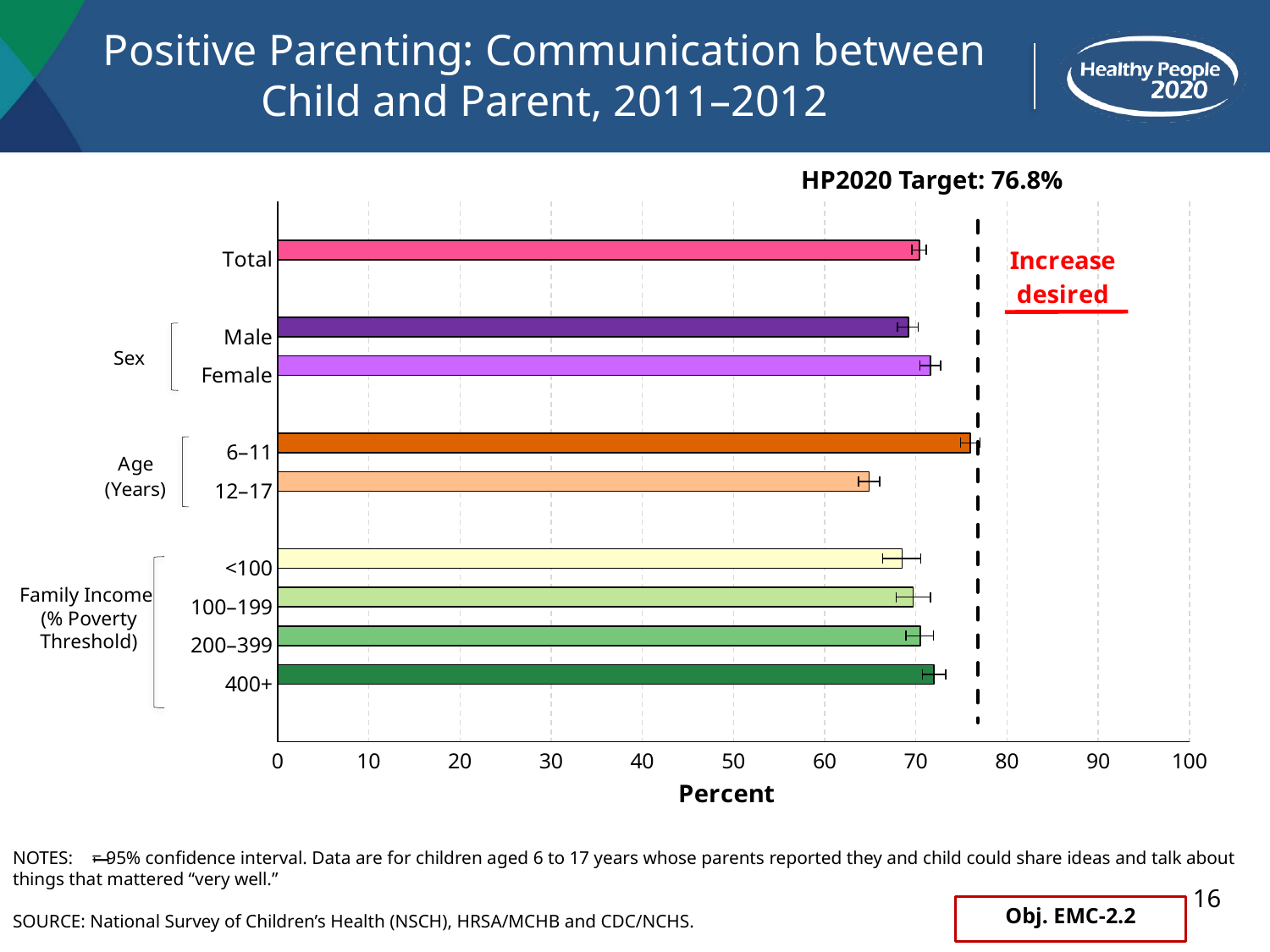
Is the value for the 12–17 age group greater or less than 70? less Which category has the lowest percentage in the chart? 12–17 Is the value for Total greater or less than 80? less What is the HP2020 Target shown on the chart? 76.8% Which category has the highest percentage in the chart? 6–11 Is the value for the 6–11 age group greater or less than 70? greater What is the label of the x axis? Percent What kind of chart is shown on the slide? Bar chart Which family income group has the larger percentage, <100 or 400+? 400+ Which age group has the larger percentage, 6–11 or 12–17? 6–11 How many bars (categories) are plotted in the chart? 9